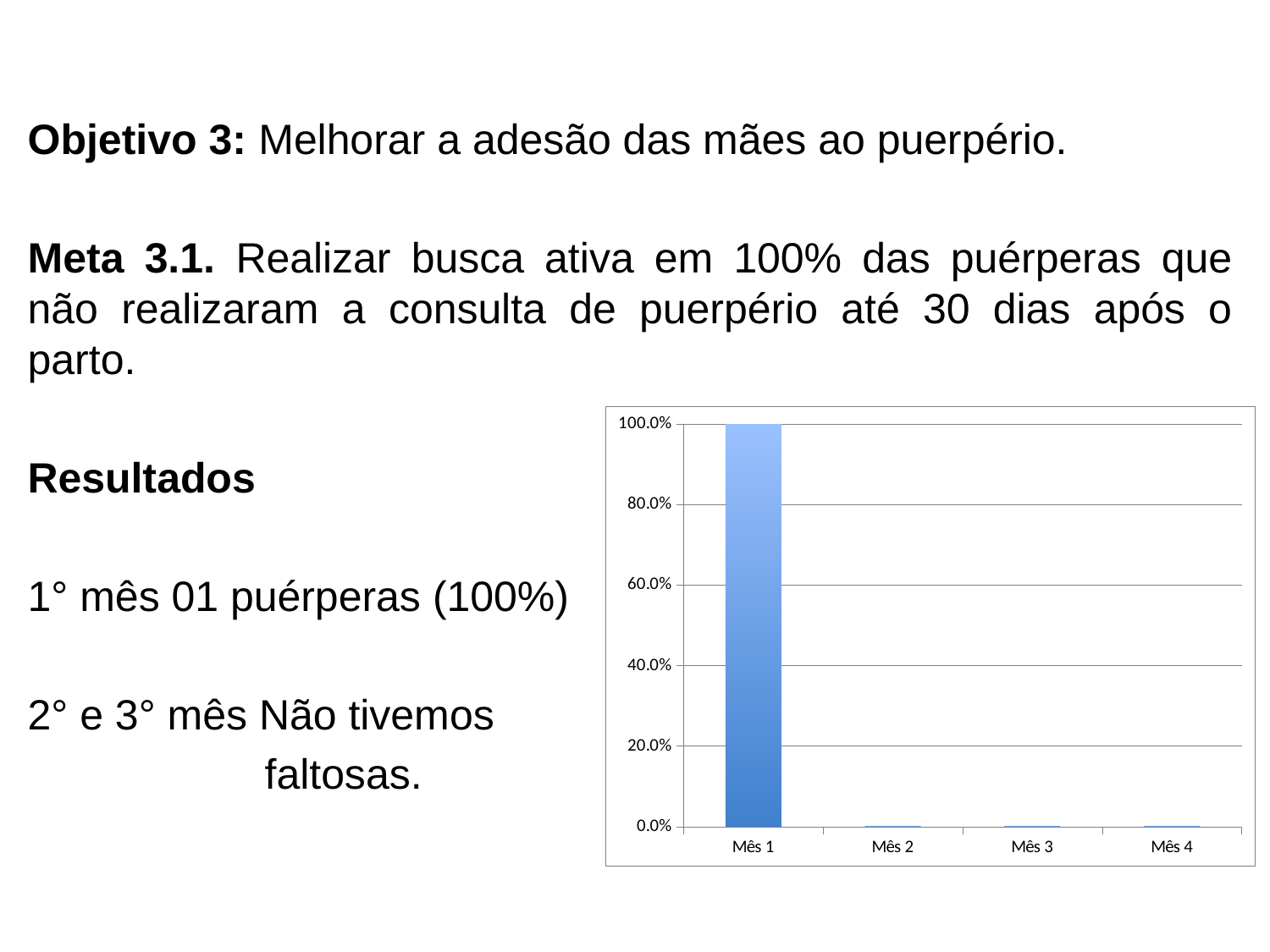
How many categories are shown on the x axis of the chart? 4 Is the value for Mês 1 greater or less than 80.0%? greater What kind of chart is shown on the slide? bar chart Is the value for Mês 4 greater or less than 40.0%? less Which month has the highest value in the chart? Mês 1 What is the value for Mês 1 in the chart? 100.0% Is the value for Mês 2 greater or less than 20.0%? less What is the highest value shown on the y axis of the chart? 100.0% What is the label of the first category on the x axis? Mês 1 Do the values rise or fall from Mês 1 to Mês 2? fall Which is larger, the value for Mês 1 or the value for Mês 3? Mês 1